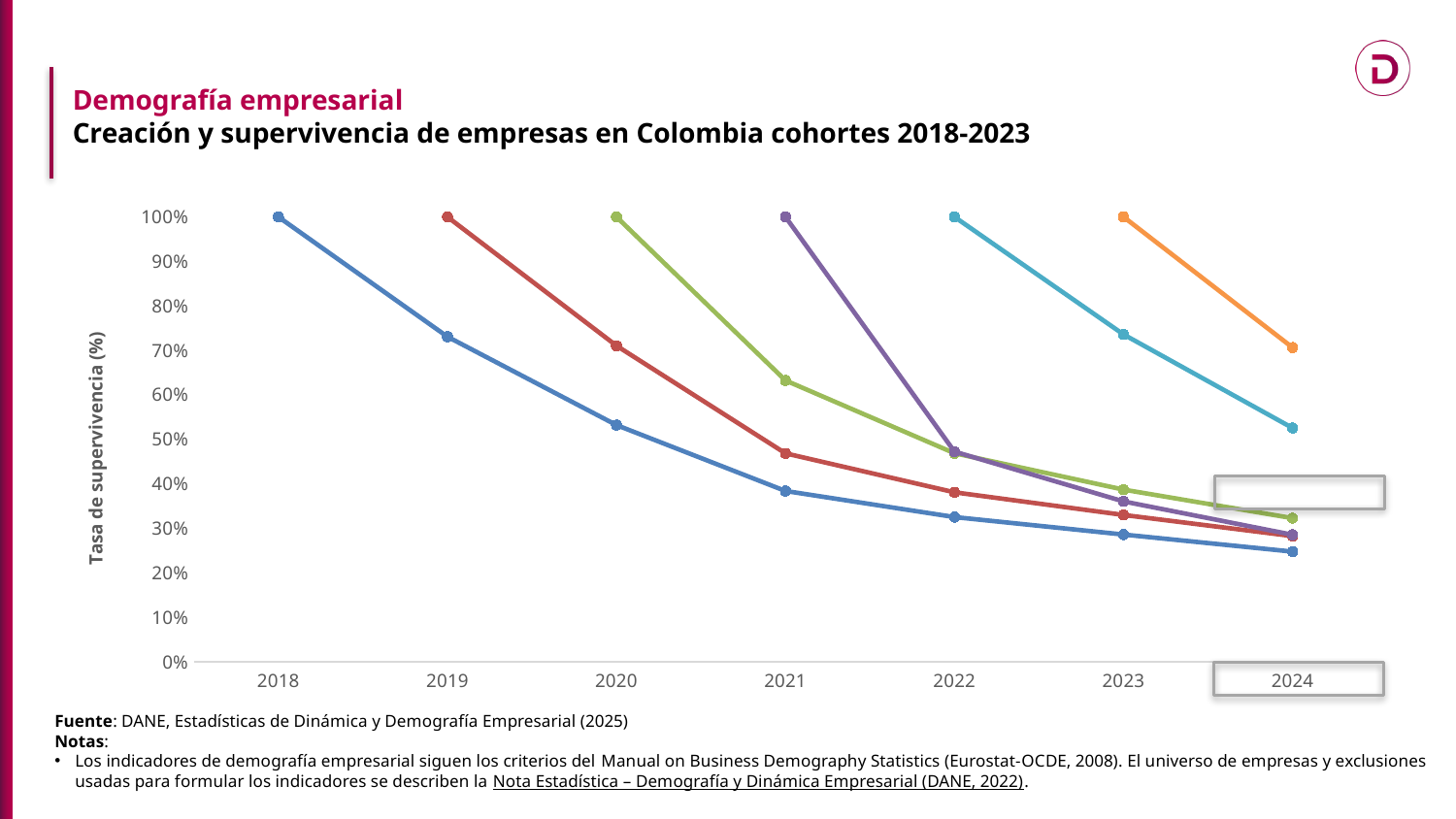
Which cohort line has the lowest value in 2024? the line starting in 2018 (blue) Is the value of the blue line (cohort starting in 2018) in 2024 greater or less than 30%? less What kind of chart is shown on the slide? line chart Is the value of the orange line (cohort starting in 2023) in 2024 greater or less than 60%? greater What is the survival rate of the orange line at the year 2023? 100% What is the title of the y axis? Tasa de supervivencia (%) How many lines (cohorts) are plotted on the chart? 6 Is the value of the red line (cohort starting in 2019) in 2021 greater or less than 60%? less What is the survival rate of the line starting in 2018 at the year 2018? 100% Does the blue line starting in 2018 rise or fall from 2018 to 2024? fall How many years are shown on the x axis of the chart? 7 In 2024, which line is higher: the orange line or the blue line? the orange line